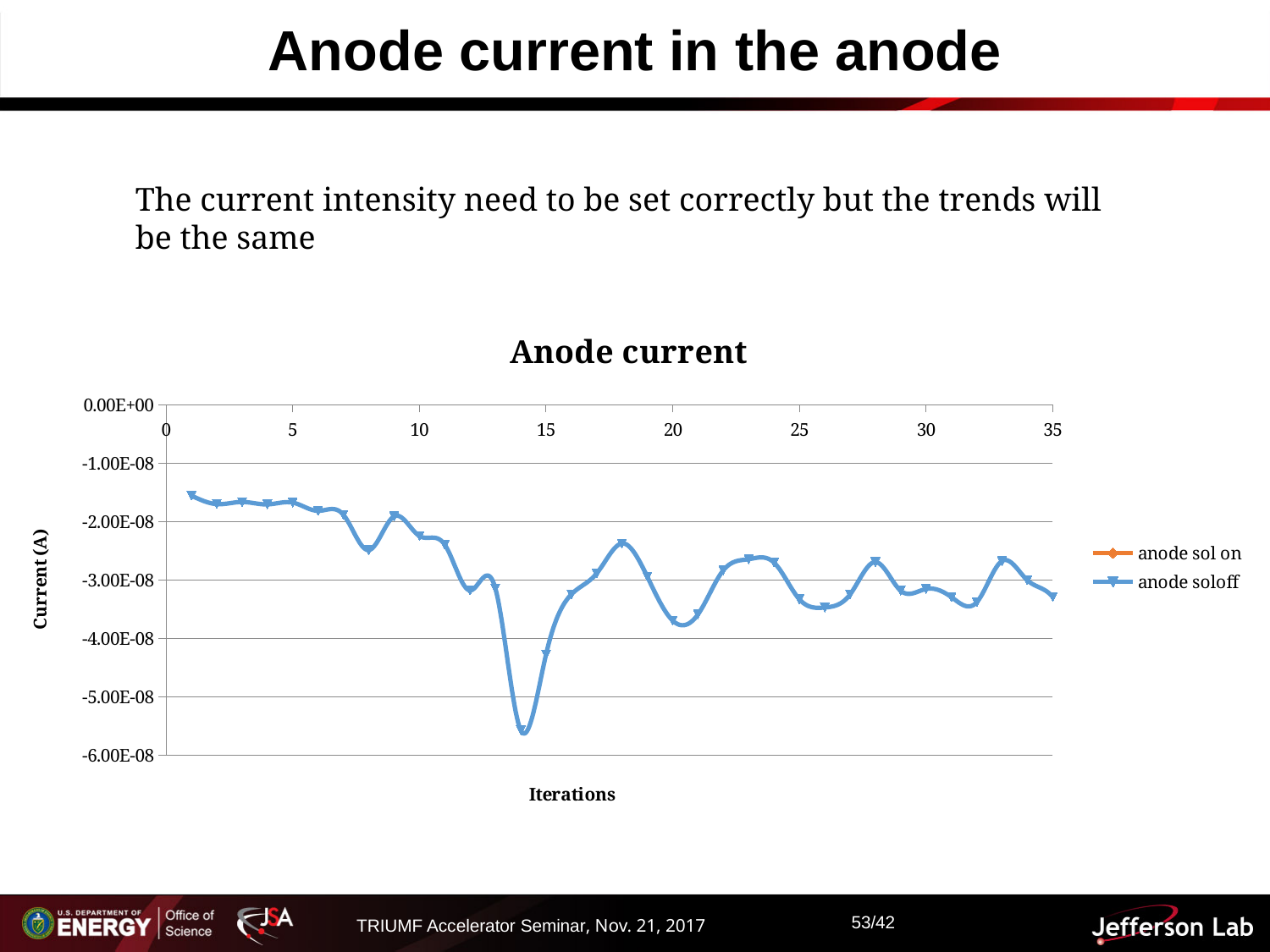
How many series does the chart legend list? 2 What kind of chart is shown on the slide? line chart Do the anode soloff values rise or fall from iteration 1 to iteration 14? fall Is the anode soloff value at iteration 14 greater or less than -5.00E-08? less Is the anode soloff value at iteration 20 greater or less than -3.00E-08? less Which is larger, the anode soloff value at iteration 1 or at iteration 14? iteration 1 What is the title of the chart? Anode current Is the anode soloff value at iteration 1 greater or less than -2.00E-08? greater At which iteration does the anode soloff series reach its lowest value? 14 What is the label of the x axis of the chart? Iterations